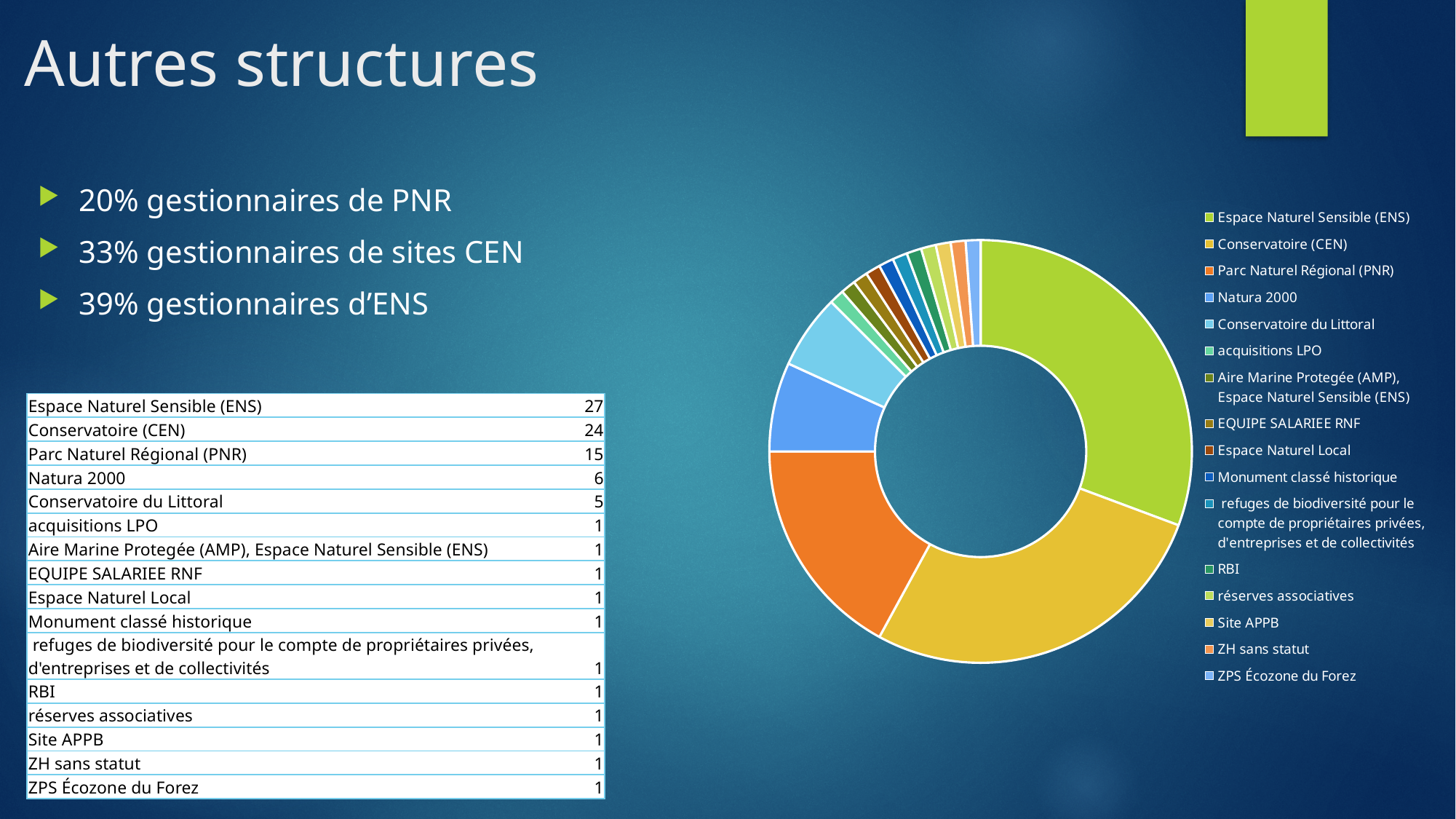
Which category has the largest slice of the chart? Espace Naturel Sensible (ENS) What kind of chart is shown on the slide? doughnut chart What is the value for Espace Naturel Sensible (ENS)? 27 What is the difference between the values for Parc Naturel Régional (PNR) and Conservatoire du Littoral? 10 What is the value for Conservatoire (CEN)? 24 What is the value for Parc Naturel Régional (PNR)? 15 What is the difference between the values for Espace Naturel Sensible (ENS) and Conservatoire (CEN)? 3 Which is larger, the value for Parc Naturel Régional (PNR) or the value for Natura 2000? Parc Naturel Régional (PNR) What is the value for Conservatoire du Littoral? 5 What is the value for Natura 2000? 6 How many categories does the chart's legend list? 16 What is the value for ZPS Écozone du Forez? 1